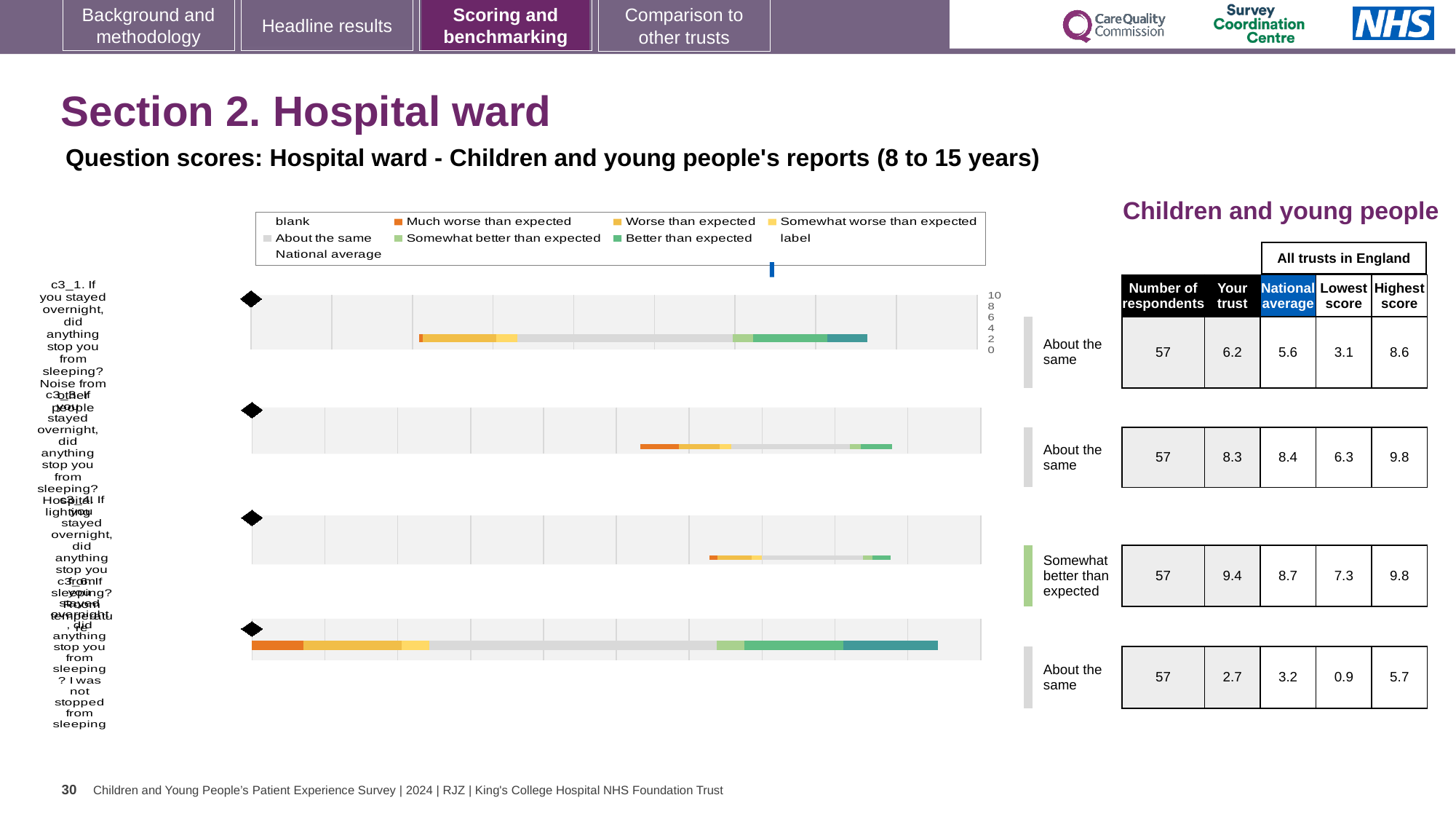
For the second row, which is larger: the 'Your trust' score or the national average? National average (8.4) For the third row, how much higher is the 'Your trust' score than the national average? 0.7 For the first row, what is the difference between the highest score and the lowest score across all trusts in England? 5.5 How many entries does the chart legend list? 9 In the table next to the chart, what is the 'Your trust' score for the first row? 6.2 In the table next to the chart, what is the national average for the third row? 8.7 Which row has the lowest 'Your trust' score in the table? the fourth row (2.7) What kind of chart is shown on the slide? bar chart How many question rows (bars) are plotted in the chart? 4 How many respondents are listed for each row in the table? 57 Which row has the highest 'Your trust' score in the table? the third row (9.4) What benchmark label is given for the third row? Somewhat better than expected